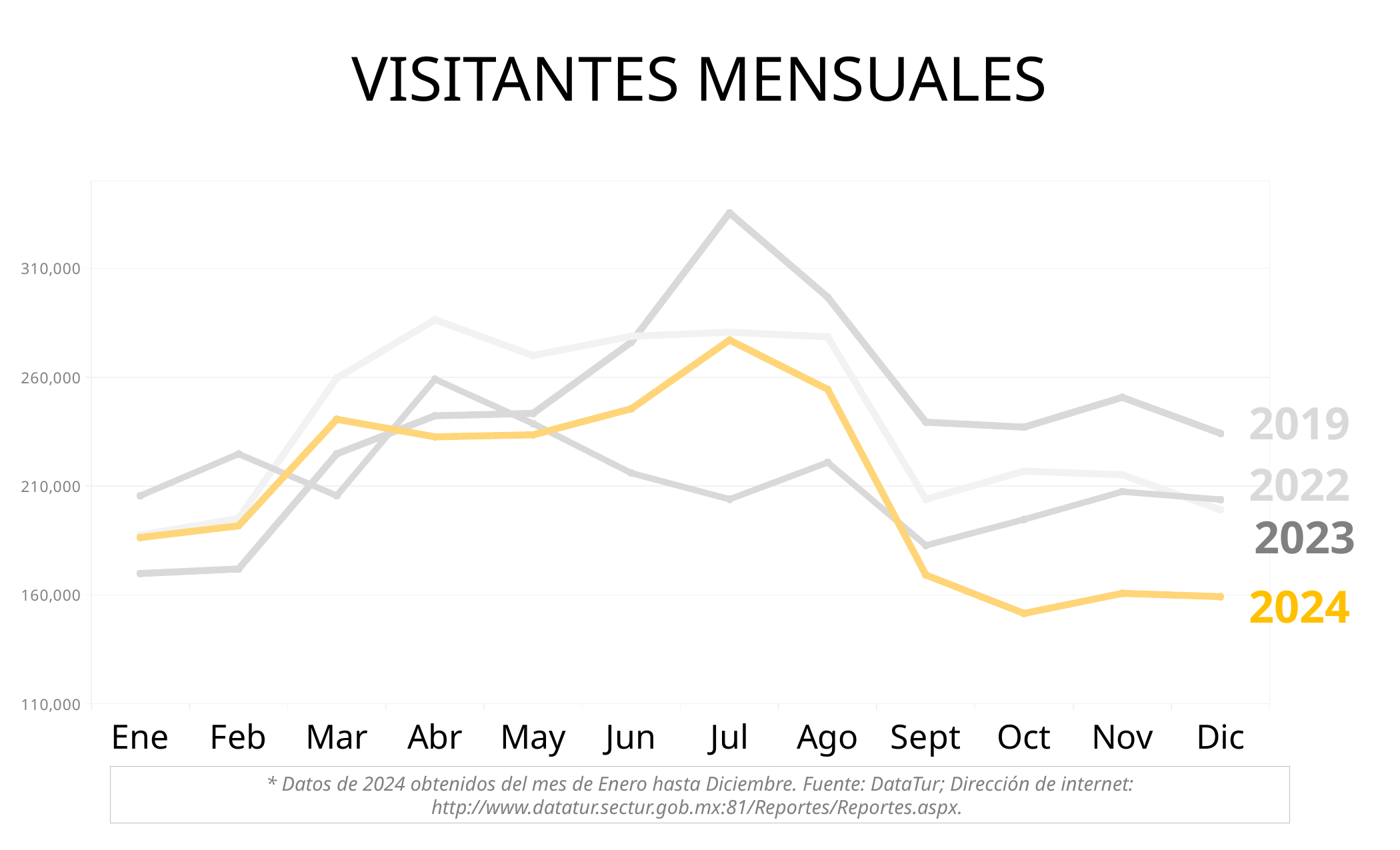
What is the title of the chart? VISITANTES MENSUALES How many series (years) does the chart show? 4 In which month does the 2024 line reach its lowest value? Oct What kind of chart is shown on the slide? line chart For 2024, which is larger: the value for Jul or the value for Ene? Jul In which month does the 2024 line reach its highest value? Jul How many months are shown along the x axis? 12 Is the 2024 value for Oct greater or less than 160,000? less Is the 2024 value for Jul greater or less than 260,000? greater Is the 2024 value for Ene greater or less than 210,000? less Which year's line is drawn in yellow? 2024 Does the 2024 line rise or fall from Ago to Oct? fall